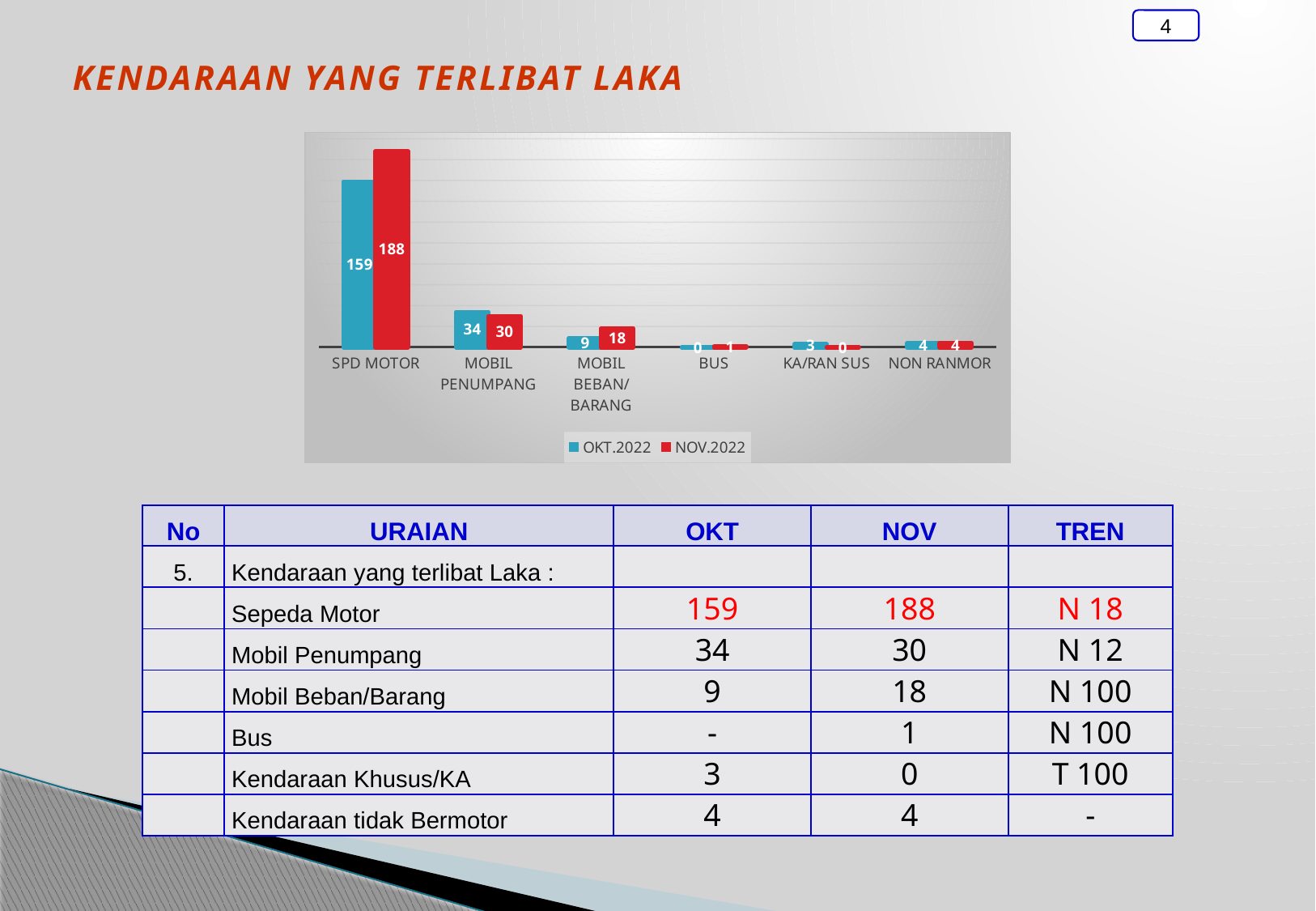
What is the value for MOBIL PENUMPANG in the OKT.2022 series? 34 Which is larger for MOBIL PENUMPANG, the OKT.2022 value or the NOV.2022 value? OKT.2022 What is the value for MOBIL BEBAN/BARANG in the NOV.2022 series? 18 What is the difference between the OKT.2022 and NOV.2022 values for MOBIL BEBAN/BARANG? 9 Which colour represents the NOV.2022 series in the chart? Red How many categories are shown on the x axis of the chart? 6 Which category has the highest value in the OKT.2022 series? SPD MOTOR What kind of chart is shown on the slide? Bar chart What is the value for SPD MOTOR in the NOV.2022 series? 188 What is the difference between the NOV.2022 and OKT.2022 values for SPD MOTOR? 29 How many series does the chart legend list? 2 Which category has the lowest value in the NOV.2022 series? KA/RAN SUS